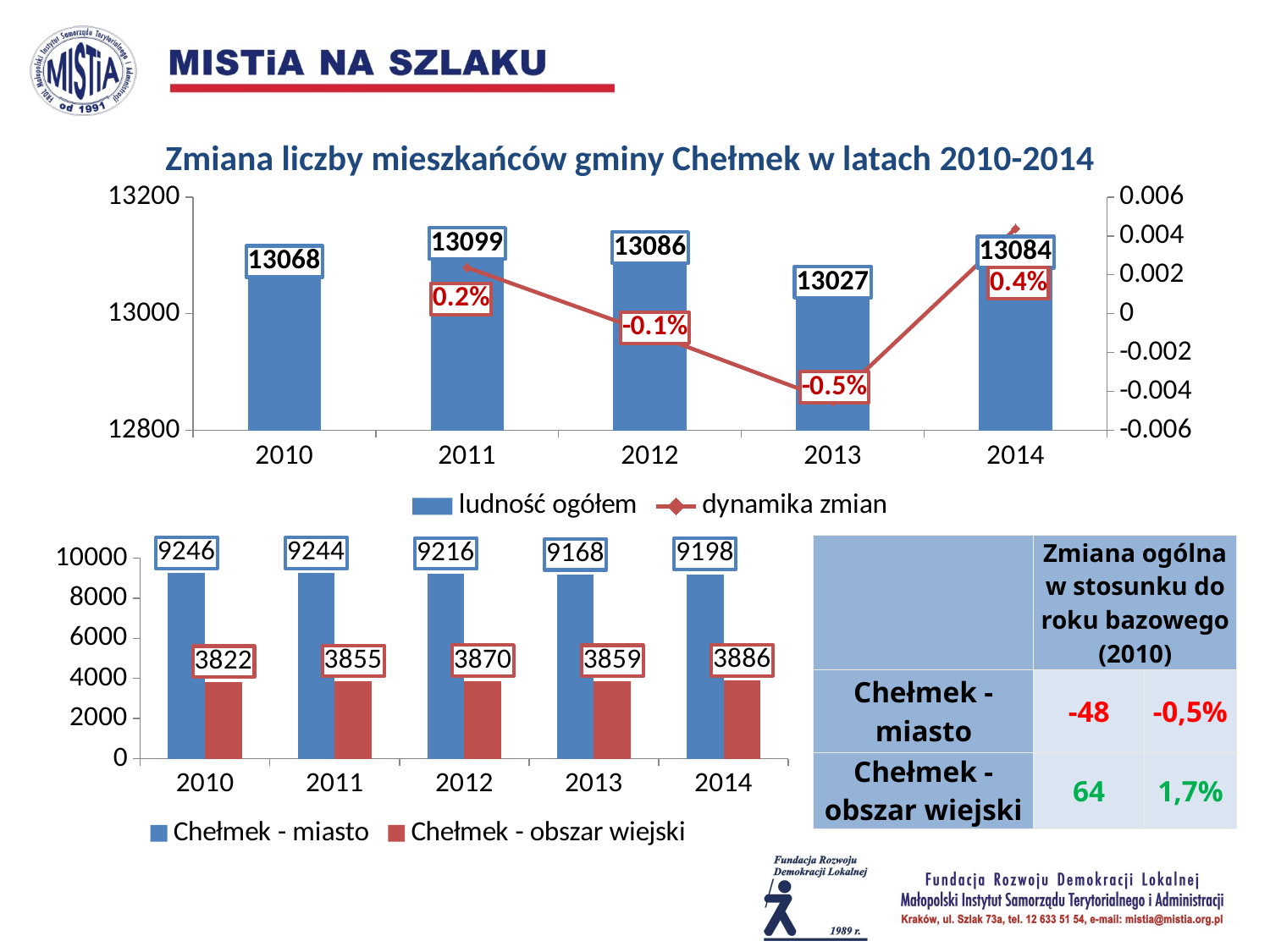
In the bottom chart, which year has the highest value for 'Chełmek - obszar wiejski'? 2014 In the top chart, what is the difference between the 'ludność ogółem' values for 2011 and 2013? 72 In the bottom chart, what is the value for 'Chełmek - obszar wiejski' in 2012? 3870 In the top chart, which year has the highest 'ludność ogółem' value? 2011 In the top chart, which year has the lowest 'ludność ogółem' value? 2013 In the bottom chart, what is the difference between 'Chełmek - miasto' and 'Chełmek - obszar wiejski' in 2010? 5424 What kind of chart is the bottom chart? bar chart How many years are shown on the x axis of the bottom chart? 5 In the top chart 'Zmiana liczby mieszkańców gminy Chełmek w latach 2010-2014', what is the value of 'ludność ogółem' for 2011? 13099 In the bottom chart, what is the value for 'Chełmek - miasto' in 2013? 9168 In the top chart, what is the 'dynamika zmian' value shown for 2013? -0.5% How many series does the legend of the top chart list? 2